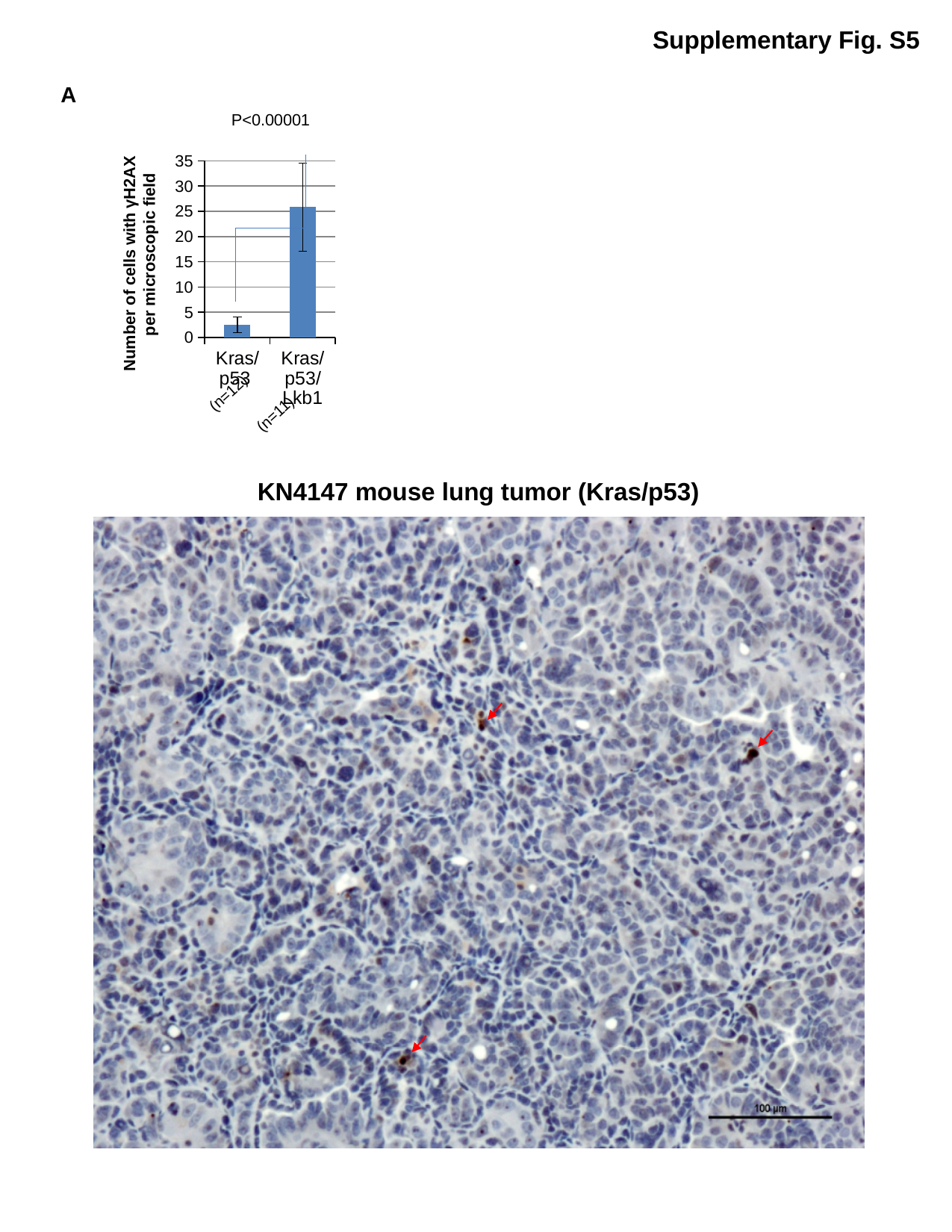
What is the highest tick value on the y-axis of the panel A chart? 35 Is the value for Kras/p53/Lkb1 greater or less than 30? less What is the y-axis label of the chart in panel A? Number of cells with γH2AX per microscopic field Which category has the lower bar in the panel A chart? Kras/p53 Is the bar for Kras/p53/Lkb1 larger or smaller than the bar for Kras/p53? larger What P value is shown above the chart in panel A? P<0.00001 What kind of chart is shown in panel A? bar chart Is the value for Kras/p53/Lkb1 greater or less than 20? greater How many categories are plotted on the bar chart in panel A? 2 Which category has the higher bar in the panel A chart? Kras/p53/Lkb1 Is the value for Kras/p53 greater or less than 5? less